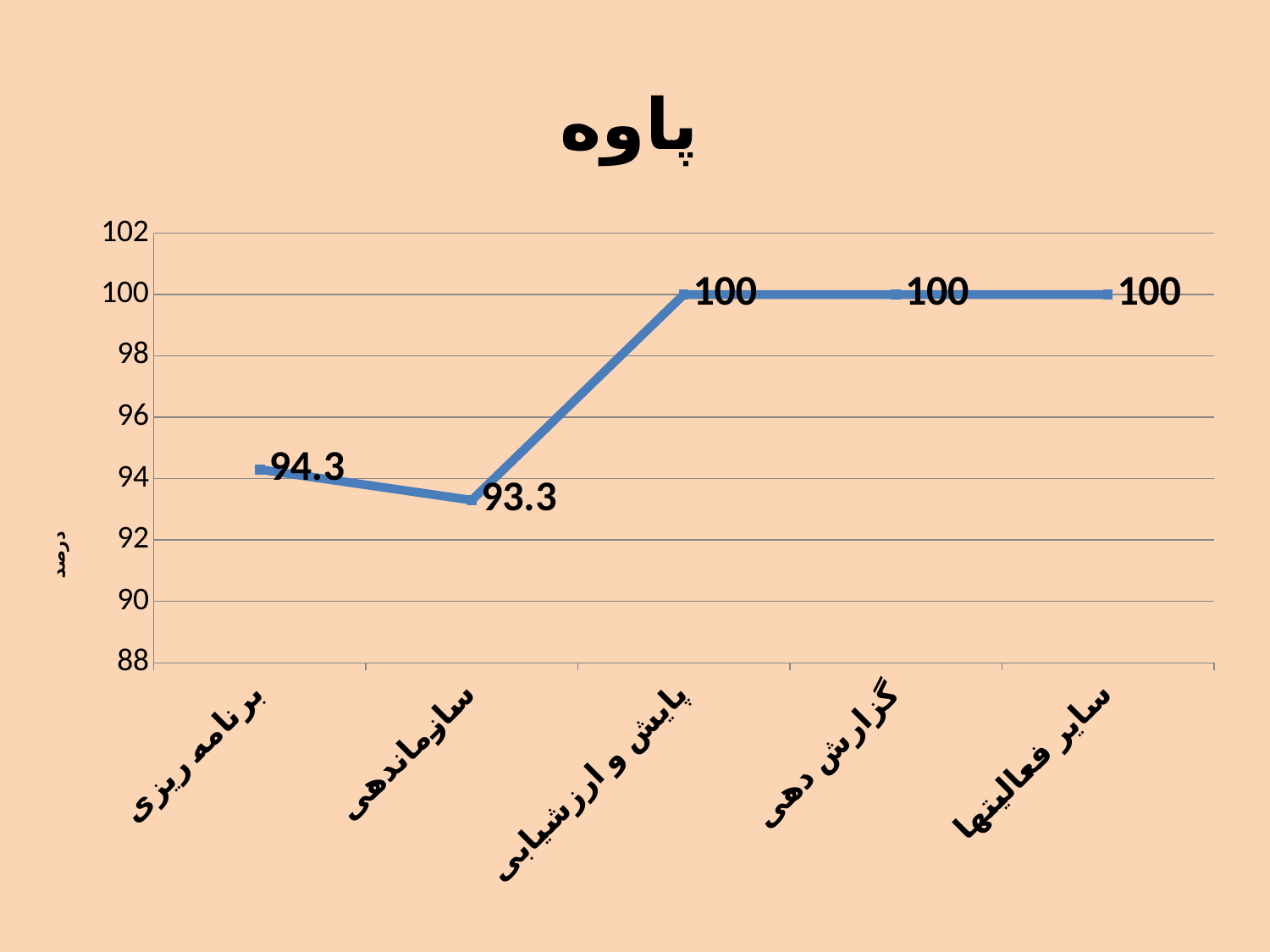
Which is larger, the value for برنامه ریزی or the value for سازماندهی? برنامه ریزی Is the value for سازماندهی greater or less than 94? less Which category has the lowest value? سازماندهی What is the difference between the values for برنامه ریزی and سازماندهی? 1 What is the value for پایش و ارزشیابی? 100 What kind of chart is shown on the slide? line chart What is the title of the chart? پاوه What is the value for برنامه ریزی? 94.3 What is the value for سازماندهی? 93.3 What is the difference between the values for پایش و ارزشیابی and سازماندهی? 6.7 How many categories are shown on the x axis? 5 What is the value for گزارش دهی? 100